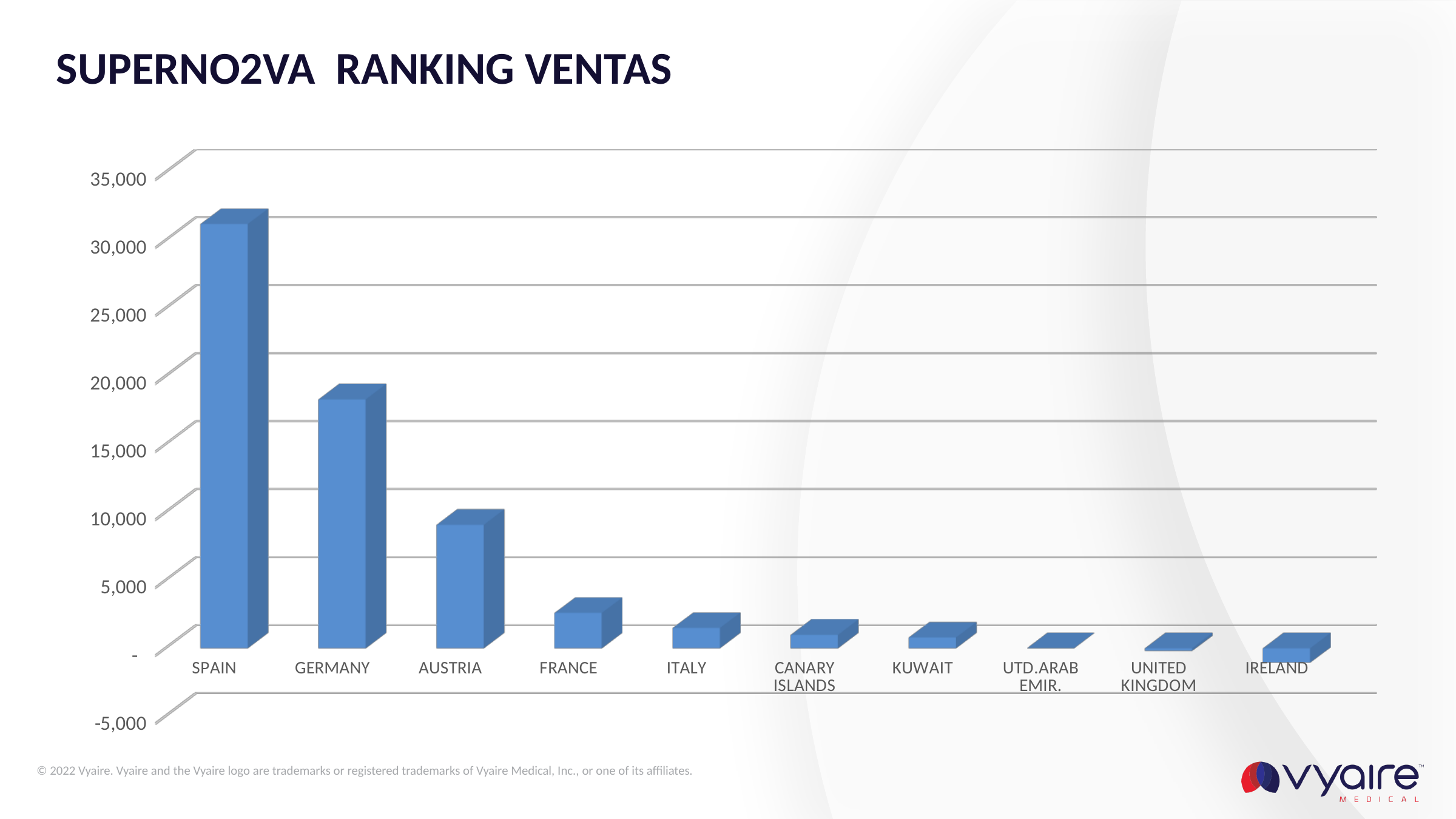
Is the value for AUSTRIA greater or less than 5,000? greater Is the value for GERMANY greater or less than 15,000? greater What kind of chart is shown on the slide? Bar chart Is the value for GERMANY greater or less than 20,000? less Which country has the lowest value? IRELAND Which country has the highest value? SPAIN Which is larger, the value for GERMANY or the value for AUSTRIA? GERMANY What is the title of the chart? SUPERNO2VA RANKING VENTAS Do the values rise or fall moving from left to right along the x axis? fall How many countries or regions are shown on the x axis? 10